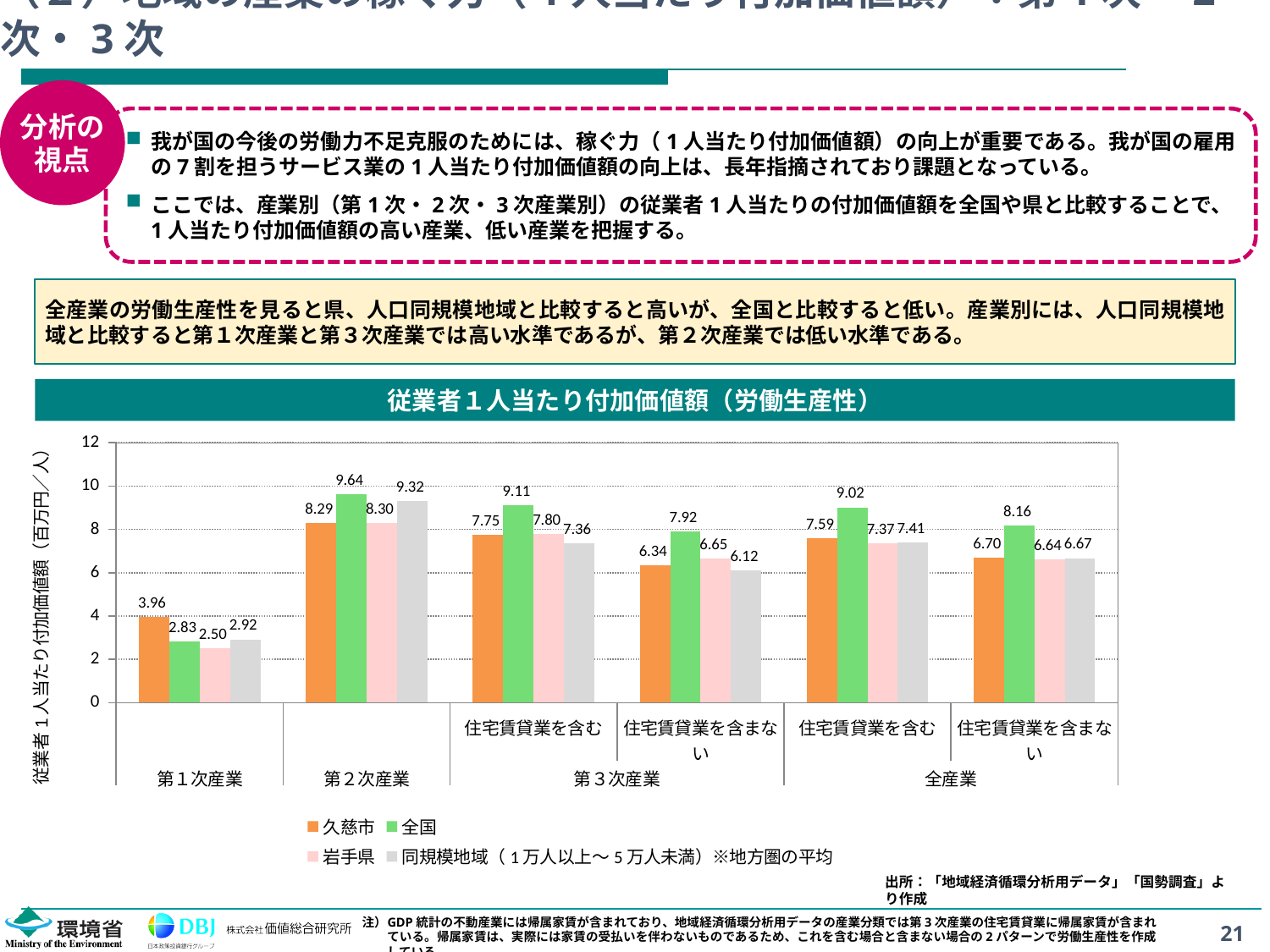
What is the difference between 全国 and 久慈市 in 全産業（住宅賃貸業を含まない）? 1.46 Which series has the lowest value in 第３次産業（住宅賃貸業を含まない）? 同規模地域 What is the value for 全国 in 第２次産業? 9.64 What is the value for 岩手県 in 第３次産業（住宅賃貸業を含まない）? 6.65 Which series has the highest value in 第１次産業? 久慈市 What is the value for 同規模地域 in 全産業（住宅賃貸業を含む）? 7.41 What kind of chart is shown on the slide? Bar chart Which is larger in 第２次産業: 久慈市 or 同規模地域? 同規模地域 What is the value for 久慈市 in 第１次産業? 3.96 What is the title of the chart? 従業者１人当たり付加価値額（労働生産性） Is the value for 全国 in 第３次産業（住宅賃貸業を含む） greater or less than 8? greater How many series does the legend list? 4